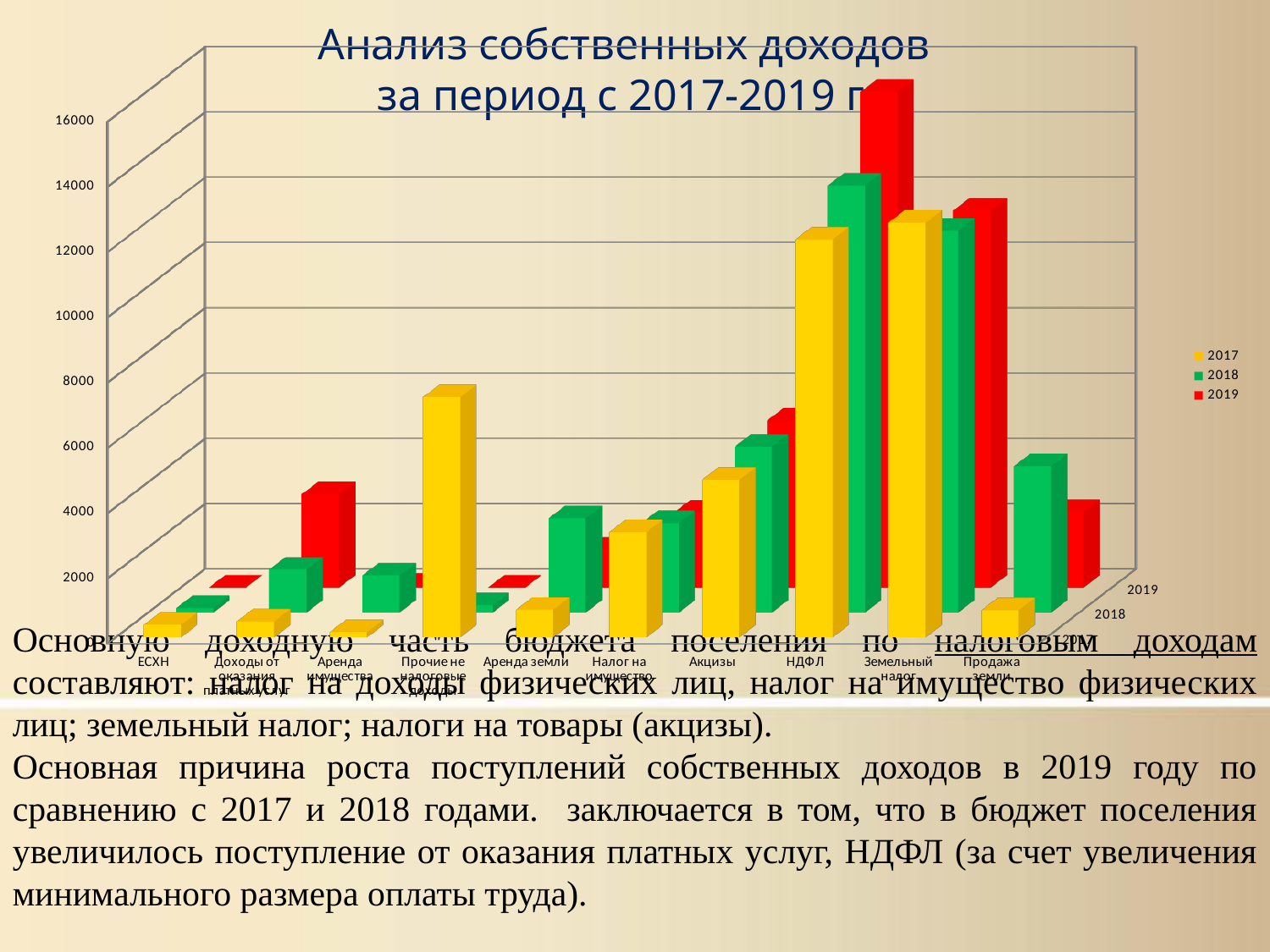
Is the 2017 value for ЕСХН greater or less than 2000? less For Прочие неналоговые доходы, which year has the larger value, 2017 or 2018? 2017 Is the 2018 value for Продажа земли greater or less than 2000? greater What kind of chart is shown on the slide? bar chart Which category has the highest value for 2019? НДФЛ Is the 2018 value for Налог на имущество greater or less than 8000? less How many categories are shown on the x axis? 10 How many series does the legend list? 3 What entries are listed in the chart legend? 2017, 2018, 2019 For Акцизы, which year has the larger value, 2017 or 2019? 2019